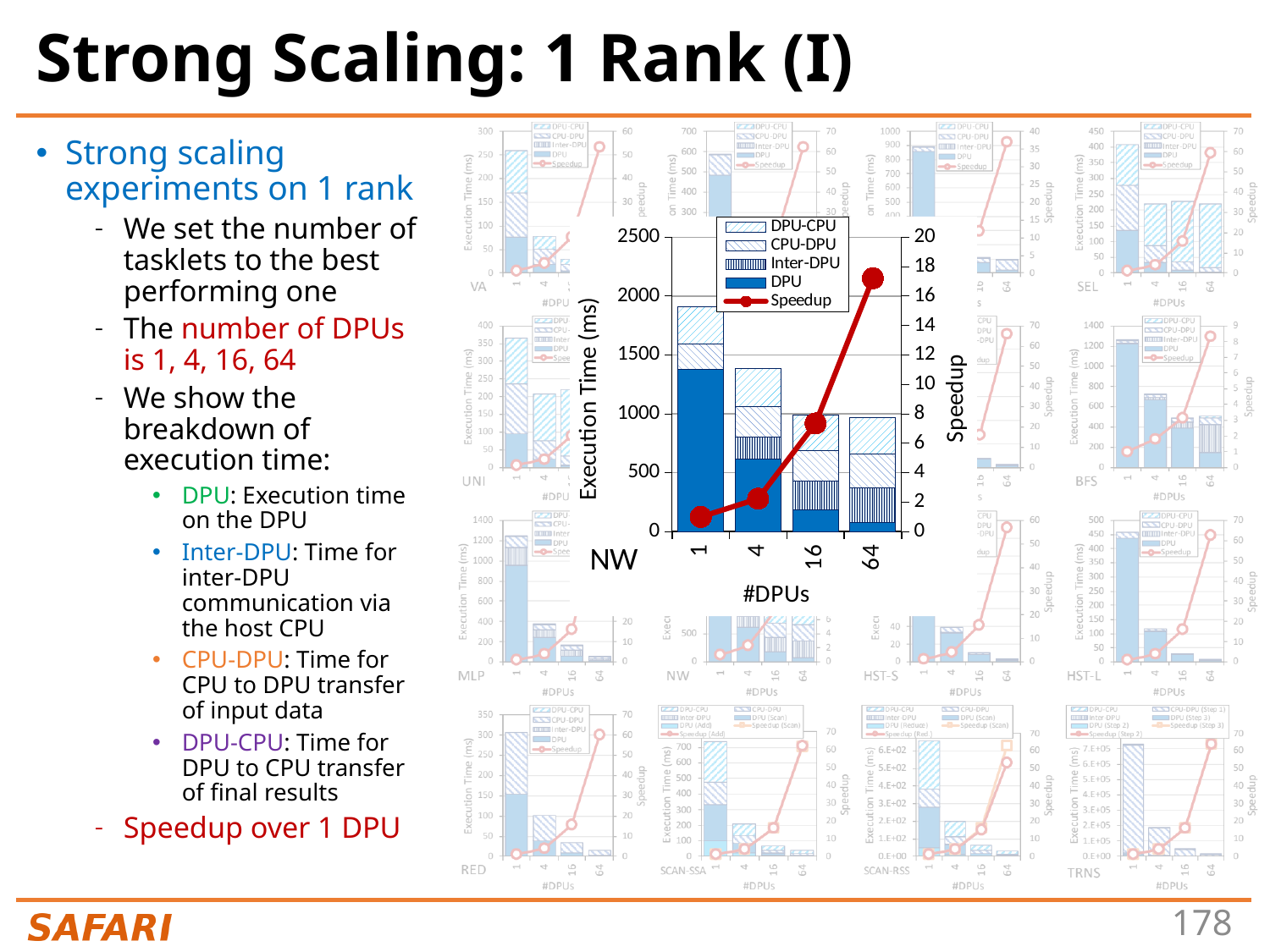
In the highlighted NW chart, which has the larger total execution time, 1 DPU or 4 DPUs? 1 DPU In the highlighted NW chart, how many series does the legend list? 5 In the highlighted NW chart, which #DPUs category has the highest total execution time? 1 In the highlighted NW chart, how many #DPUs categories are shown on the x axis? 4 In the highlighted NW chart, which #DPUs category has the lowest speedup? 1 In the highlighted NW chart, which #DPUs category has the highest speedup? 64 In the highlighted NW chart, how does the speedup change as the number of DPUs increases from 1 to 64? It rises In the highlighted NW chart, is the speedup for 64 DPUs greater or less than 14? greater In the highlighted NW chart, is the speedup for 16 DPUs greater or less than 10? less In the highlighted NW chart, is the total execution time for 1 DPU greater or less than 1500 ms? greater What kind of chart is the highlighted NW chart? Stacked bar chart with a line What is the x-axis title of the highlighted NW chart? #DPUs